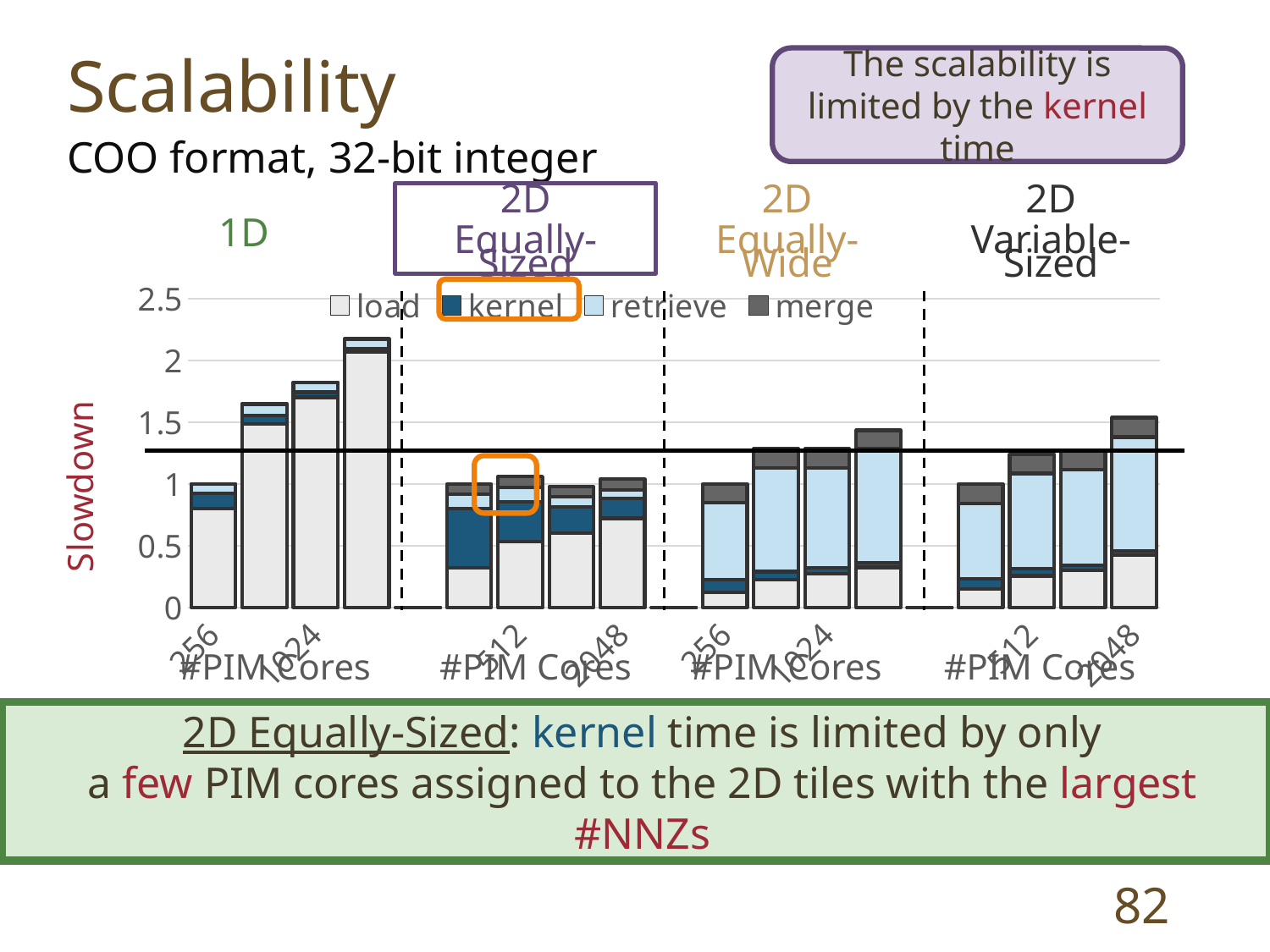
How many series does the chart legend list? 4 In the 1D group, do the bar totals rise or fall as the number of PIM cores increases from 256 to 2048? rise What are the series names listed in the chart legend? load, kernel, retrieve, merge In the 1D group, which number of PIM cores has the shortest bar? 256 Is the total slowdown for 2048 PIM cores in the 1D group greater or less than 2? greater What kind of chart is shown on the slide? bar chart How many bars are in the 1D group of the chart? 4 Is the total slowdown for 256 PIM cores in the 2D Equally-Sized group greater or less than 1.5? less In the 1D group, which number of PIM cores has the tallest bar? 2048 How many bars are plotted in total across all four groups of the chart? 16 What is the label of the vertical axis of the chart? Slowdown Is the total slowdown for 2048 PIM cores in the 2D Equally-Wide group greater or less than 1? greater